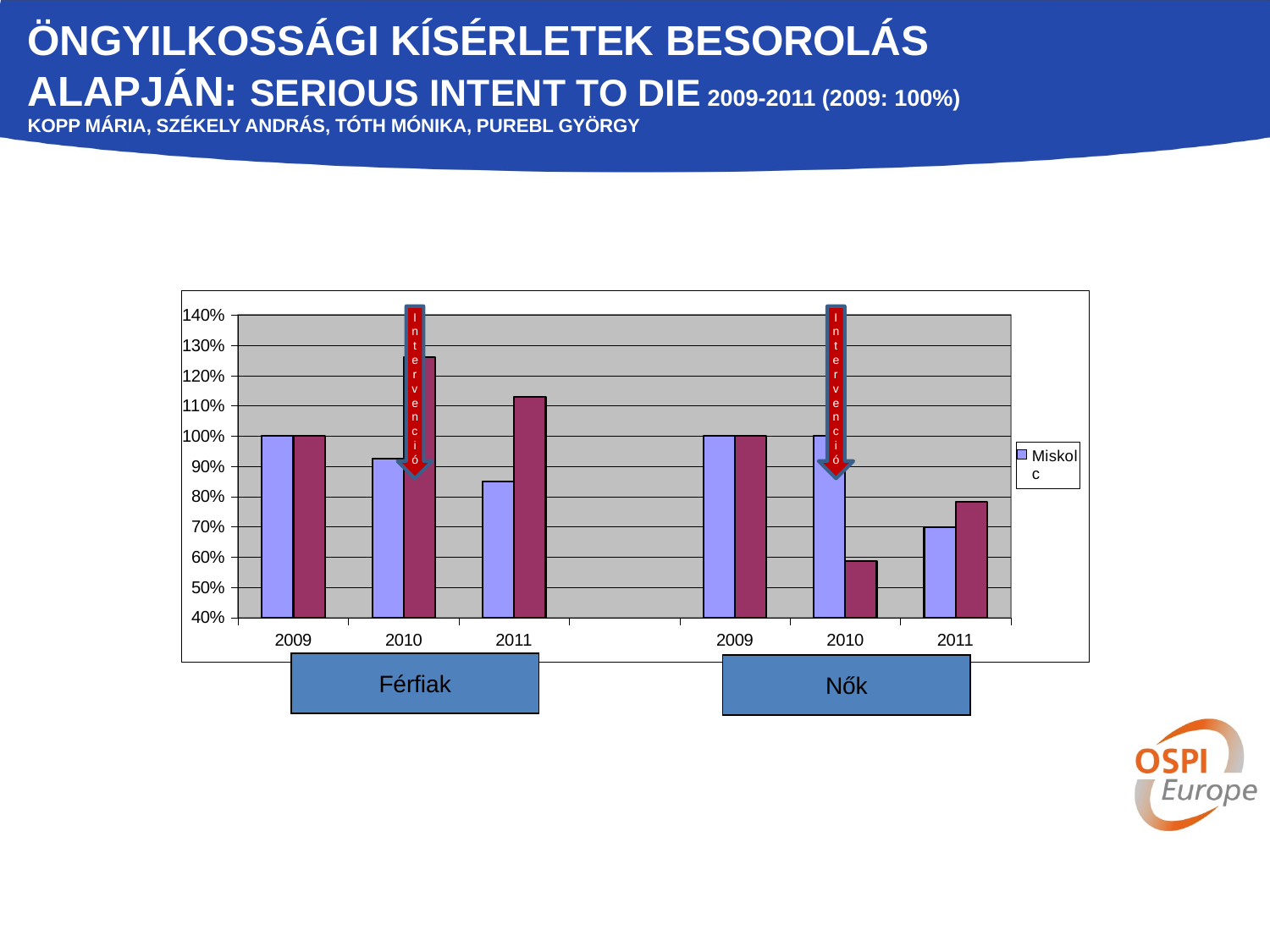
Is the value of the Miskolc (light blue) bar for Férfiak in 2011 greater or less than 90%? less Is the value of the dark red bar for Nők in 2010 greater or less than 70%? less What is the value of the Miskolc (light blue) bar for Férfiak in 2009? 100% What is the value of the Miskolc (light blue) bar for Nők in 2010? 100% Is the value of the dark red bar for Férfiak in 2010 greater or less than 120%? greater What kind of chart is shown on the slide? bar chart For Nők in 2010, which bar is higher: the Miskolc (light blue) bar or the dark red bar? the Miskolc (light blue) bar How many year categories are shown in the Férfiak group? 3 For Férfiak in 2010, which bar is higher: the Miskolc (light blue) bar or the dark red bar? the dark red bar Does the Miskolc (light blue) series rise or fall from 2009 to 2011 in the Nők group? fall Which year has the highest dark red bar in the Férfiak group? 2010